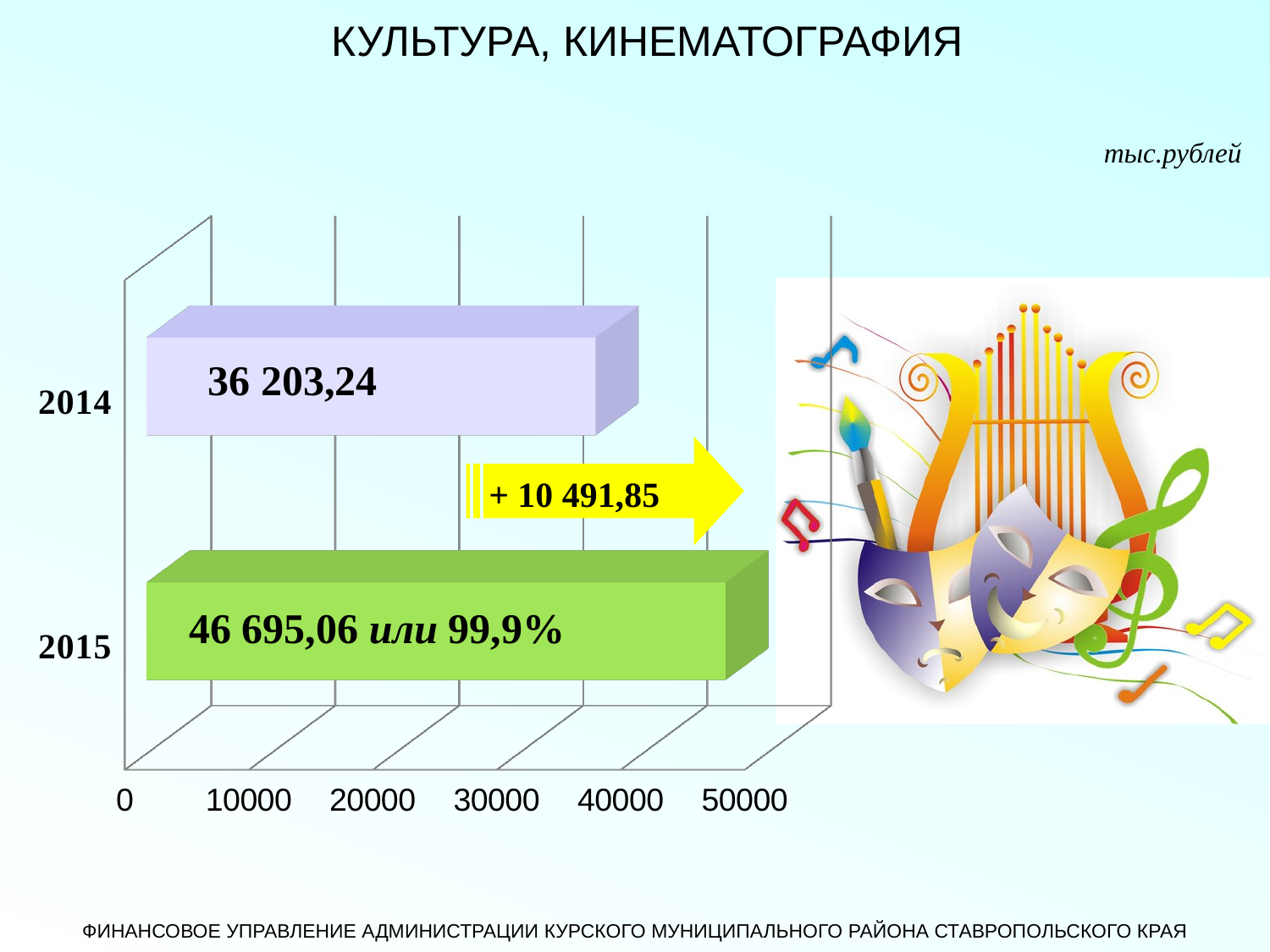
Is the value for 2014 larger or smaller than the value for 2015? smaller What is the difference between the 2015 and 2014 values? 10 491,82 What is the value for 2014? 36 203,24 What percentage is printed on the 2015 bar? 99,9% Is the value for 2014 greater or less than 40000? less Is the value for 2015 greater or less than 40000? greater What is the value for 2015? 46 695,06 Which year has the higher value? 2015 How many years are shown in the chart? 2 Which year has the lower value? 2014 What kind of chart is shown on the slide? bar chart What unit of measurement is indicated for the chart? тыс.рублей